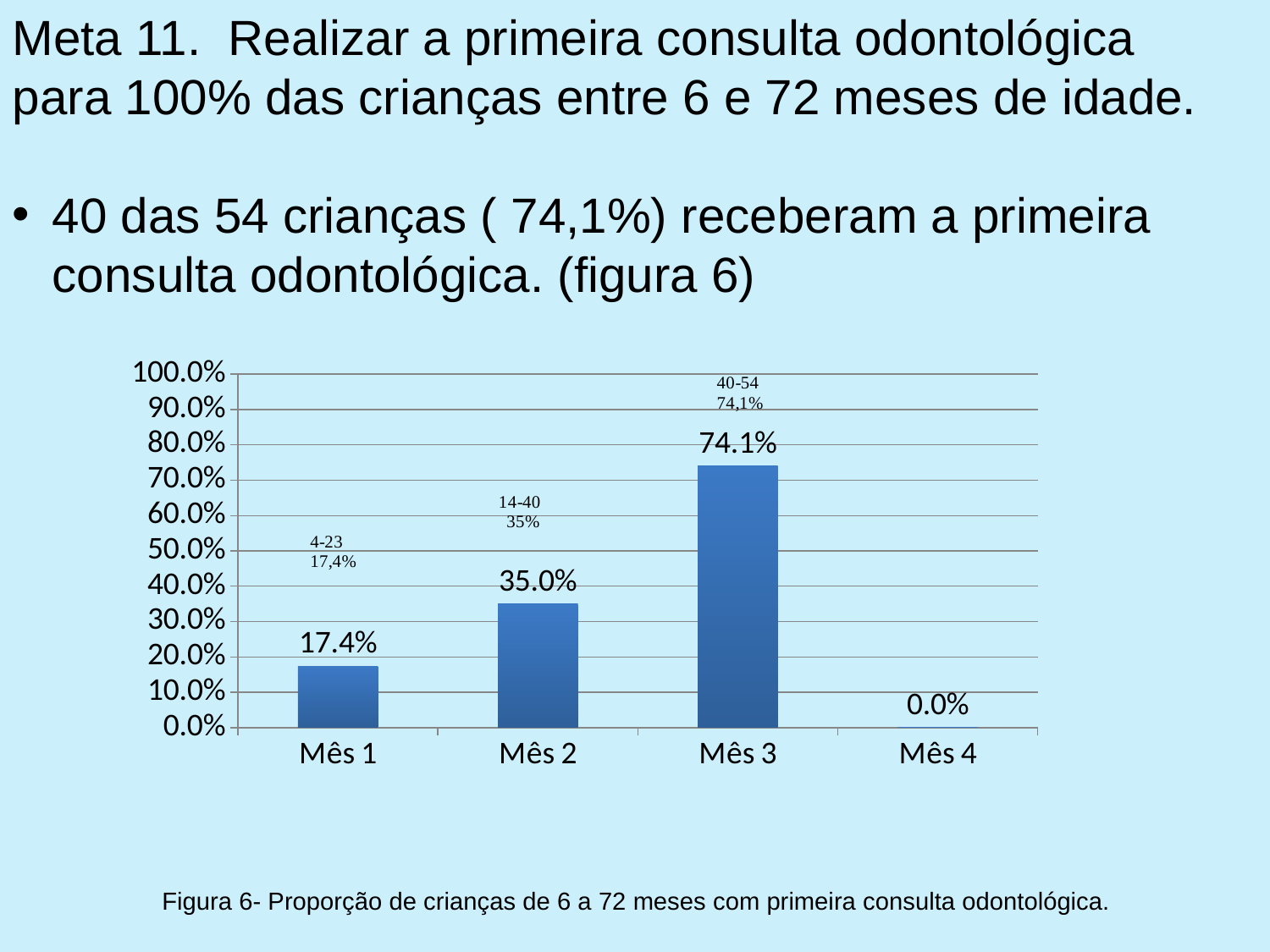
Which month has the lowest value? Mês 4 What is the value for Mês 2? 35.0% What is the difference between the values for Mês 2 and Mês 1? 17.6% What is the caption of the figure below the chart? Figura 6- Proporção de crianças de 6 a 72 meses com primeira consulta odontológica. What is the value for Mês 1? 17.4% What kind of chart is shown on the slide? Bar chart What is the difference between the values for Mês 3 and Mês 2? 39.1% What is the value for Mês 4? 0.0% Which month has the highest value? Mês 3 Which is larger, the value for Mês 1 or the value for Mês 2? Mês 2 How many months are shown on the x axis? 4 What is the value for Mês 3? 74.1%